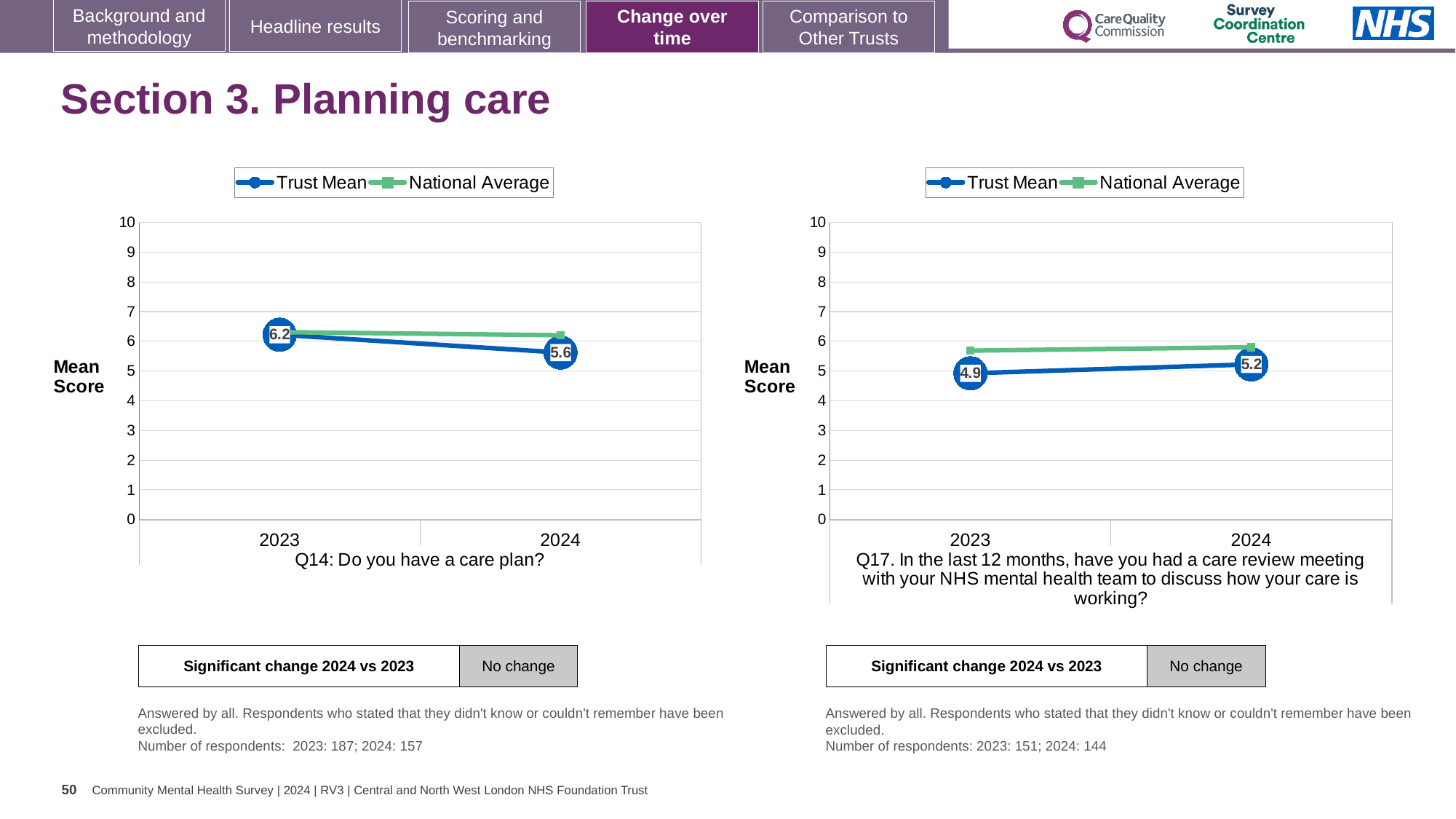
In the Q17 chart (right), what is the Trust Mean score for 2024? 5.2 In the Q14 chart (left), what is the Trust Mean score for 2023? 6.2 What kind of chart is the Q17 chart (right)? line chart In the Q17 chart (right), does the Trust Mean rise or fall from 2023 to 2024? rise In the Q17 chart (right), by how much did the Trust Mean change from 2023 to 2024? 0.3 In the Q17 chart (right), what is the Trust Mean score for 2023? 4.9 In the Q14 chart (left), does the Trust Mean rise or fall from 2023 to 2024? fall In the Q14 chart (left), is the National Average value for 2024 greater or less than 5? greater How many series does the legend of the Q14 chart (left) list? 2 In the Q14 chart (left), by how much did the Trust Mean change from 2023 to 2024? 0.6 In the Q17 chart (right), which series has the higher value in 2023, Trust Mean or National Average? National Average In the Q14 chart (left), what is the Trust Mean score for 2024? 5.6